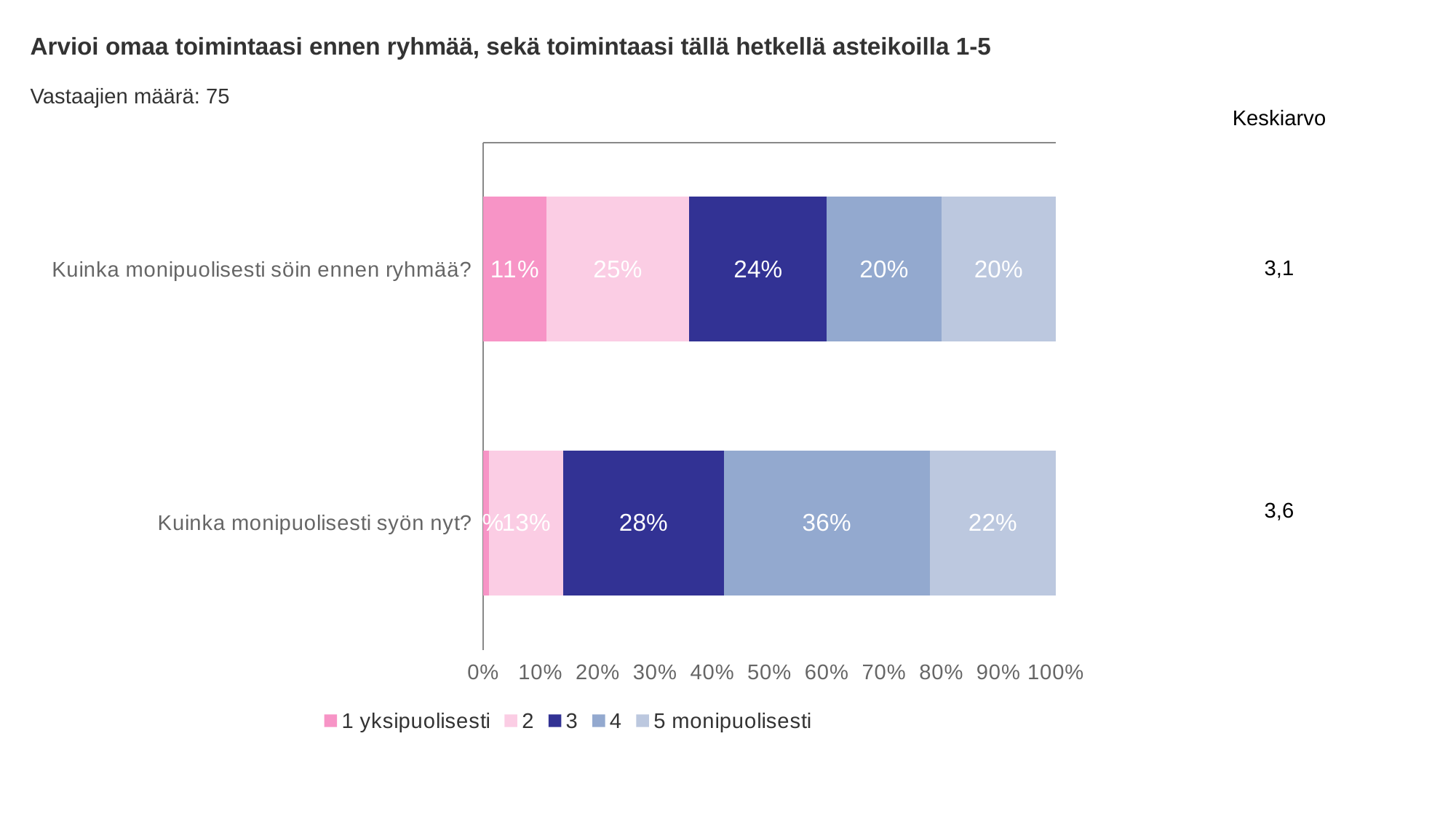
What kind of chart is shown on the slide? Stacked bar chart How many questions (bars) are shown in the chart? 2 What percentage of respondents chose "5 monipuolisesti" for "Kuinka monipuolisesti syön nyt?"? 22% What percentage of respondents chose "3" for "Kuinka monipuolisesti söin ennen ryhmää?"? 24% What is the Keskiarvo (mean) shown for "Kuinka monipuolisesti syön nyt?"? 3,6 Which response option has the largest share in the bar for "Kuinka monipuolisesti söin ennen ryhmää?"? 2 What percentage of respondents chose "1 yksipuolisesti" for "Kuinka monipuolisesti söin ennen ryhmää?"? 11% Which response option has the largest share in the bar for "Kuinka monipuolisesti syön nyt?"? 4 What percentage of respondents chose "4" for "Kuinka monipuolisesti syön nyt?"? 36% How many percentage points higher is the share of "4" for "Kuinka monipuolisesti syön nyt?" than for "Kuinka monipuolisesti söin ennen ryhmää?"? 16 percentage points Is the share of "3" larger for "Kuinka monipuolisesti söin ennen ryhmää?" or for "Kuinka monipuolisesti syön nyt?"? Kuinka monipuolisesti syön nyt? How many response options does the legend list? 5